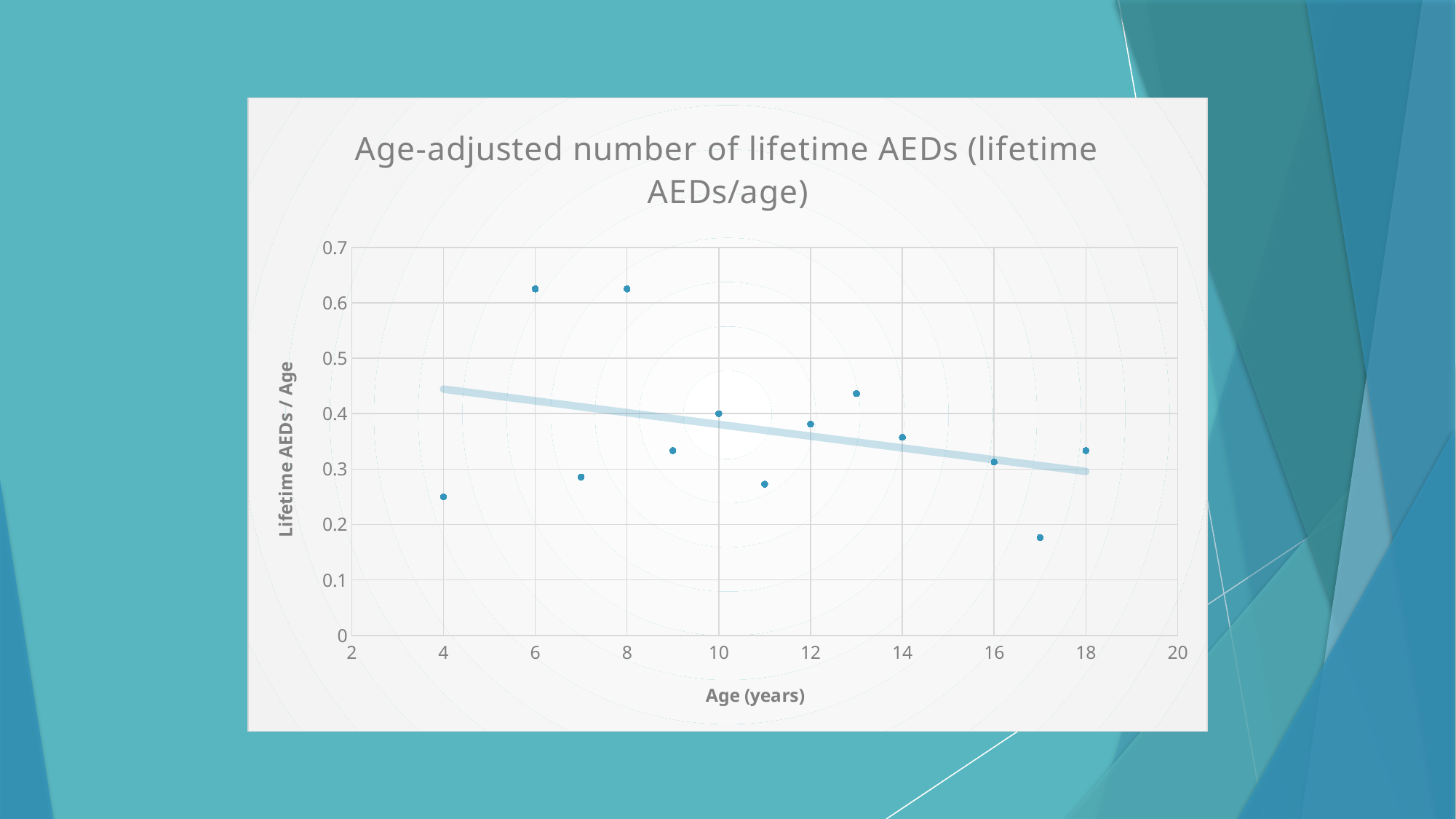
What kind of chart is shown on the slide? scatter chart Does the trendline rise or fall as age increases? falls Which has the larger value, age 17 or age 18? age 18 What is the label of the x axis? Age (years) Is the value for age 17 greater or less than 0.2? less Which has the larger value, age 6 or age 4? age 6 Is the value for age 13 greater or less than 0.4? greater Is the value for age 6 greater or less than 0.6? greater Which age has the lowest value of lifetime AEDs / age? 17 How many data points are plotted in the chart? 13